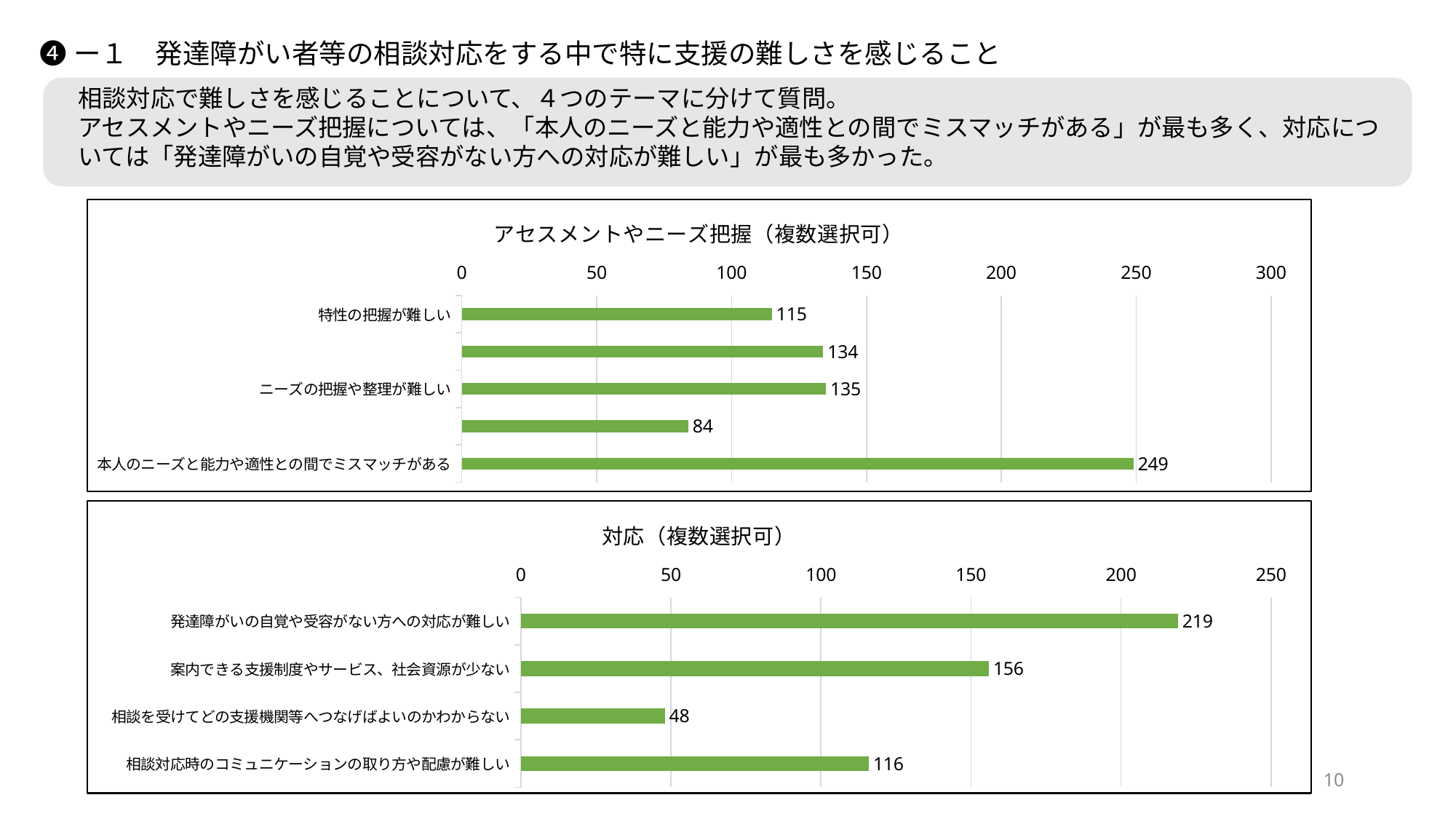
In the chart titled アセスメントやニーズ把握（複数選択可）, what is the value for 特性の把握が難しい? 115 In the chart titled 対応（複数選択可）, what is the value for 発達障がいの自覚や受容がない方への対応が難しい? 219 In the chart titled アセスメントやニーズ把握（複数選択可）, what is the difference between 本人のニーズと能力や適性との間でミスマッチがある and 特性の把握が難しい? 134 In the chart titled アセスメントやニーズ把握（複数選択可）, which category has the highest value? 本人のニーズと能力や適性との間でミスマッチがある In the chart titled アセスメントやニーズ把握（複数選択可）, what is the value for ニーズの把握や整理が難しい? 135 What type of chart is the chart titled 対応（複数選択可）? Bar chart In the chart titled 対応（複数選択可）, what is the value for 相談を受けてどの支援機関等へつなげばよいのかわからない? 48 In the chart titled 対応（複数選択可）, which is larger: 案内できる支援制度やサービス、社会資源が少ない or 相談対応時のコミュニケーションの取り方や配慮が難しい? 案内できる支援制度やサービス、社会資源が少ない In the chart titled 対応（複数選択可）, which category has the lowest value? 相談を受けてどの支援機関等へつなげばよいのかわからない In the chart titled アセスメントやニーズ把握（複数選択可）, what is the value for 本人のニーズと能力や適性との間でミスマッチがある? 249 In the chart titled 対応（複数選択可）, what is the difference between 発達障がいの自覚や受容がない方への対応が難しい and 案内できる支援制度やサービス、社会資源が少ない? 63 In the chart titled アセスメントやニーズ把握（複数選択可）, how many bars are plotted? 5